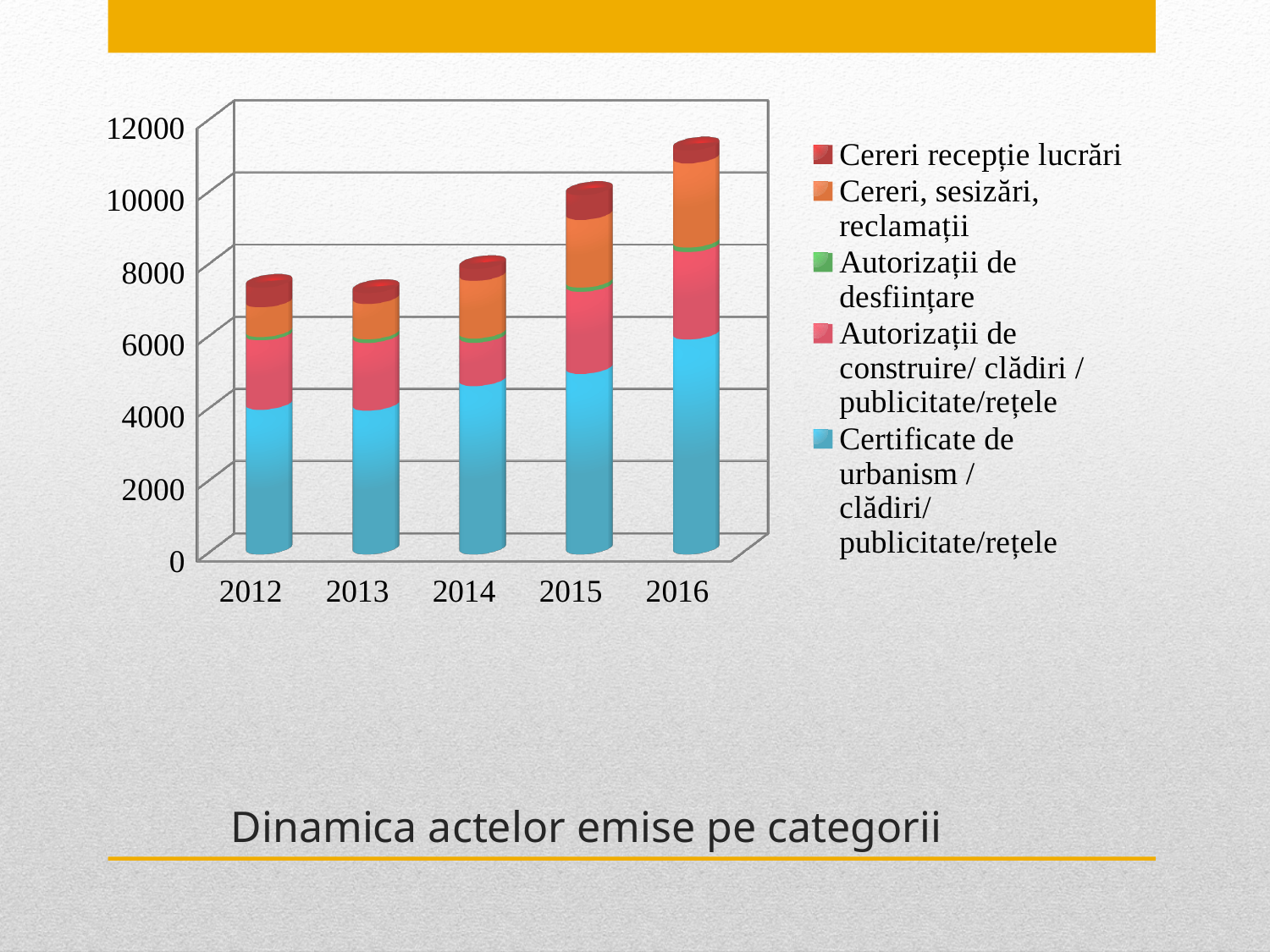
How many years are shown on the x axis of the chart? 5 Is the total stacked value for 2016 greater or less than 10000? greater Do the total stacked values rise or fall from 2014 to 2016? rise Is the value of 'Certificate de urbanism / clădiri/ publicitate/rețele' for 2016 greater or less than 4000? greater What is the title shown below the chart? Dinamica actelor emise pe categorii Is the total stacked value for 2012 greater or less than 8000? less Which series is shown in blue at the bottom of each stacked bar? Certificate de urbanism / clădiri/ publicitate/rețele How many series does the chart legend list? 5 Which year has the tallest stacked bar? 2016 Which year has the larger total stacked bar, 2014 or 2015? 2015 What kind of chart is shown on the slide? stacked bar chart